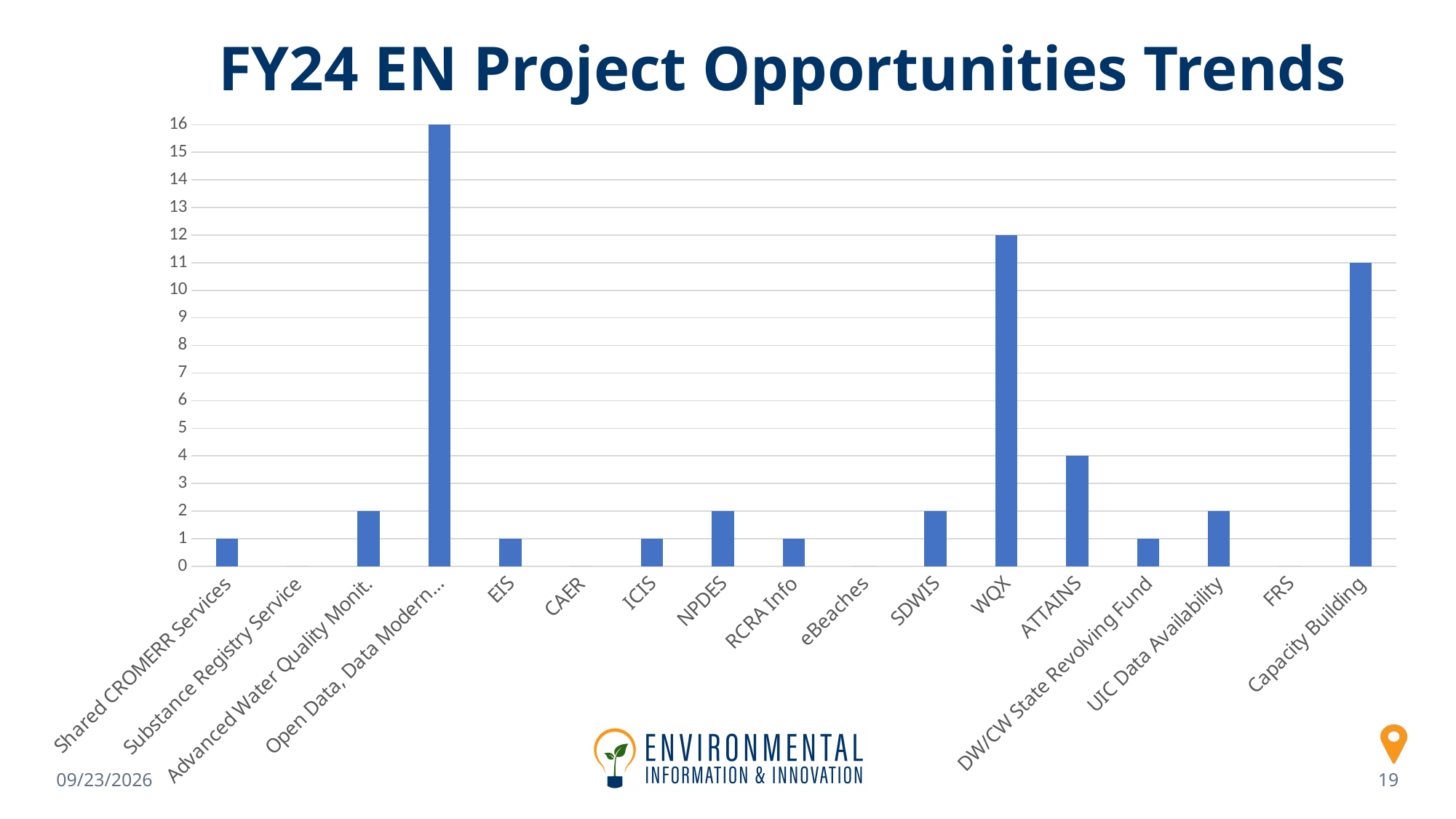
Which has a larger value, ATTAINS or SDWIS? ATTAINS What kind of chart is shown on the slide? Bar chart What is the value for WQX? 12 Which category has the highest value? Open Data, Data Modern… What is the value for Capacity Building? 11 What is the difference between the values for WQX and Capacity Building? 1 What is the value for ATTAINS? 4 What is the title of the chart? FY24 EN Project Opportunities Trends How many categories are shown on the x axis of the chart? 17 What is the value for Shared CROMERR Services? 1 Is the value for WQX greater or less than 10? greater What is the value for NPDES? 2